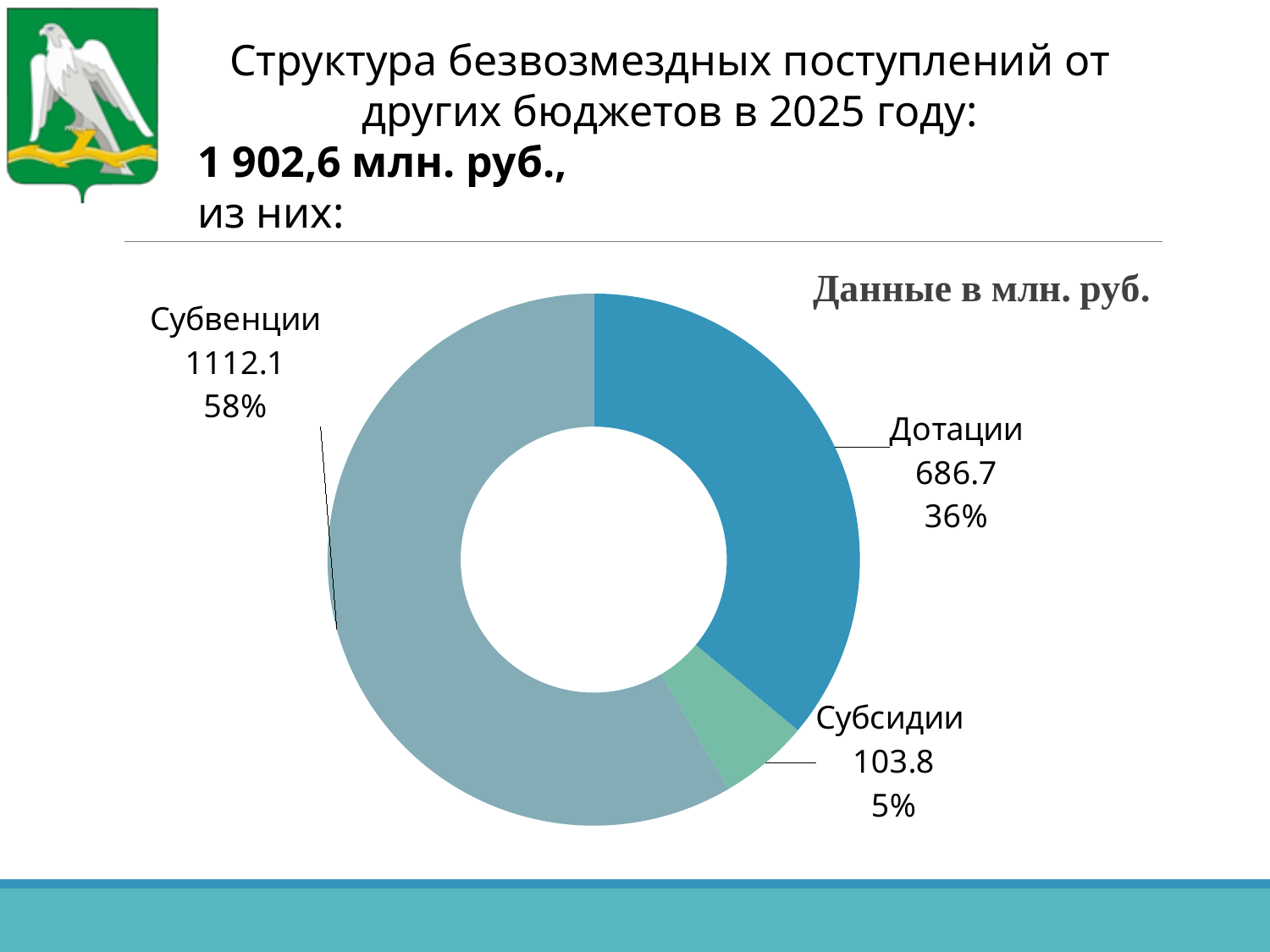
In what units are the chart data given, according to the note on the slide? млн. руб. Which is larger, the value for Дотации or the value for Субсидии? Дотации Which category has the largest share of the chart? Субвенции What percentage share does Дотации have? 36% What is the value for Субвенции on the chart? 1112.1 Which category has the smallest share of the chart? Субсидии What is the value for Дотации on the chart? 686.7 How many categories are shown on the chart? 3 What percentage share does Субсидии have? 5% What is the value for Субсидии on the chart? 103.8 What is the difference between the values for Субвенции and Дотации? 425.4 What kind of chart is shown on the slide? Doughnut (pie) chart